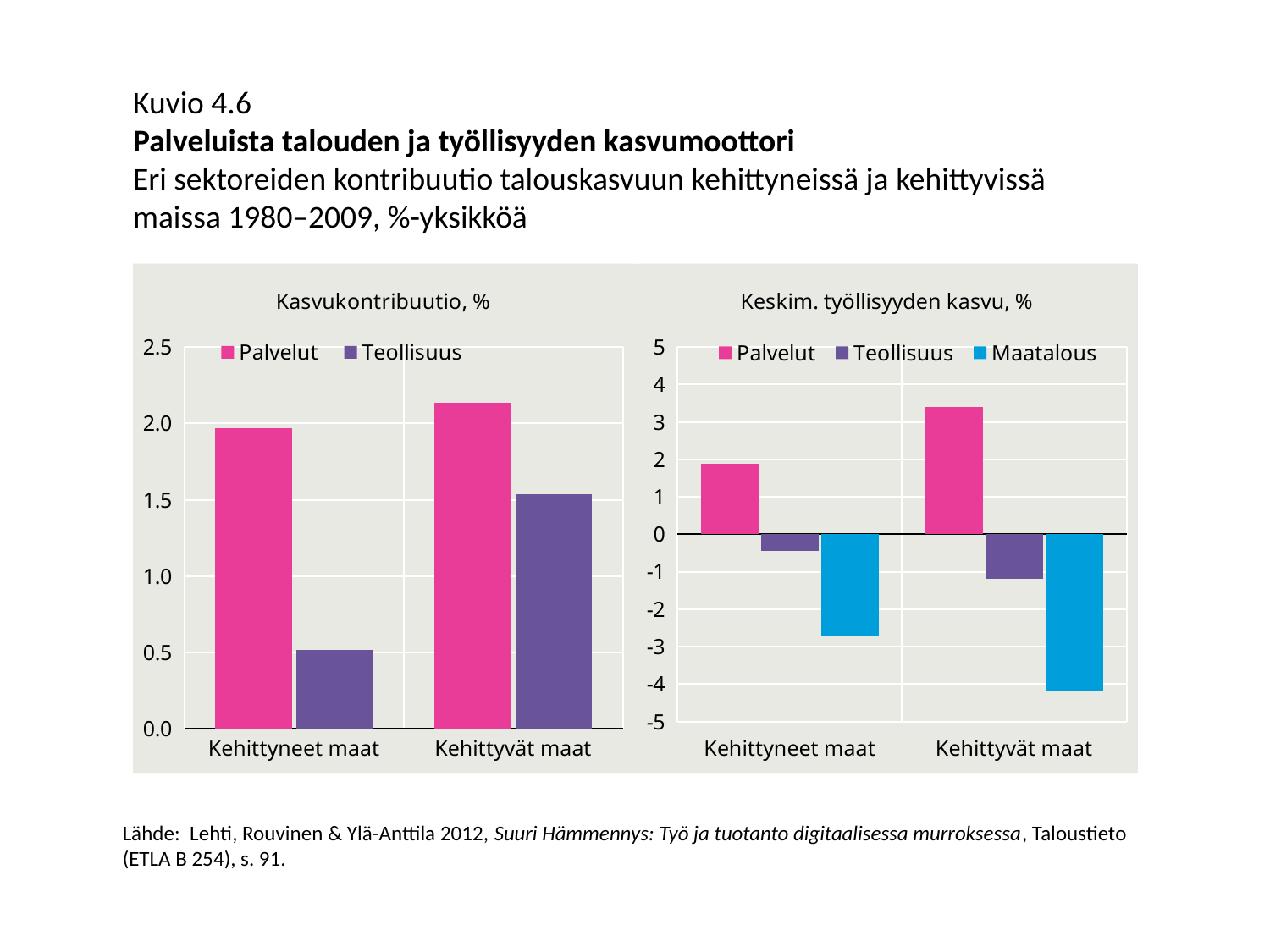
In the left chart (Kasvukontribuutio, %), what kind of chart is shown? bar chart In the left chart (Kasvukontribuutio, %), how many series does the legend list? 2 In the right chart (Keskim. työllisyyden kasvu, %), is the Palvelut value for Kehittyvät maat greater or less than 3? greater In the left chart (Kasvukontribuutio, %), which category has the larger Teollisuus value, Kehittyneet maat or Kehittyvät maat? Kehittyvät maat In the right chart (Keskim. työllisyyden kasvu, %), how many series does the legend list? 3 What is the title of the right chart on the slide? Keskim. työllisyyden kasvu, % In the left chart (Kasvukontribuutio, %), how many categories are shown on the x axis? 2 In the right chart (Keskim. työllisyyden kasvu, %), is the Maatalous value for Kehittyneet maat greater or less than -2? less In the left chart (Kasvukontribuutio, %), which series and category has the highest bar? Palvelut, Kehittyvät maat In the right chart (Keskim. työllisyyden kasvu, %), which series and category has the lowest value? Maatalous, Kehittyvät maat In the left chart (Kasvukontribuutio, %), is the Palvelut value for Kehittyvät maat greater or less than 2.0? greater